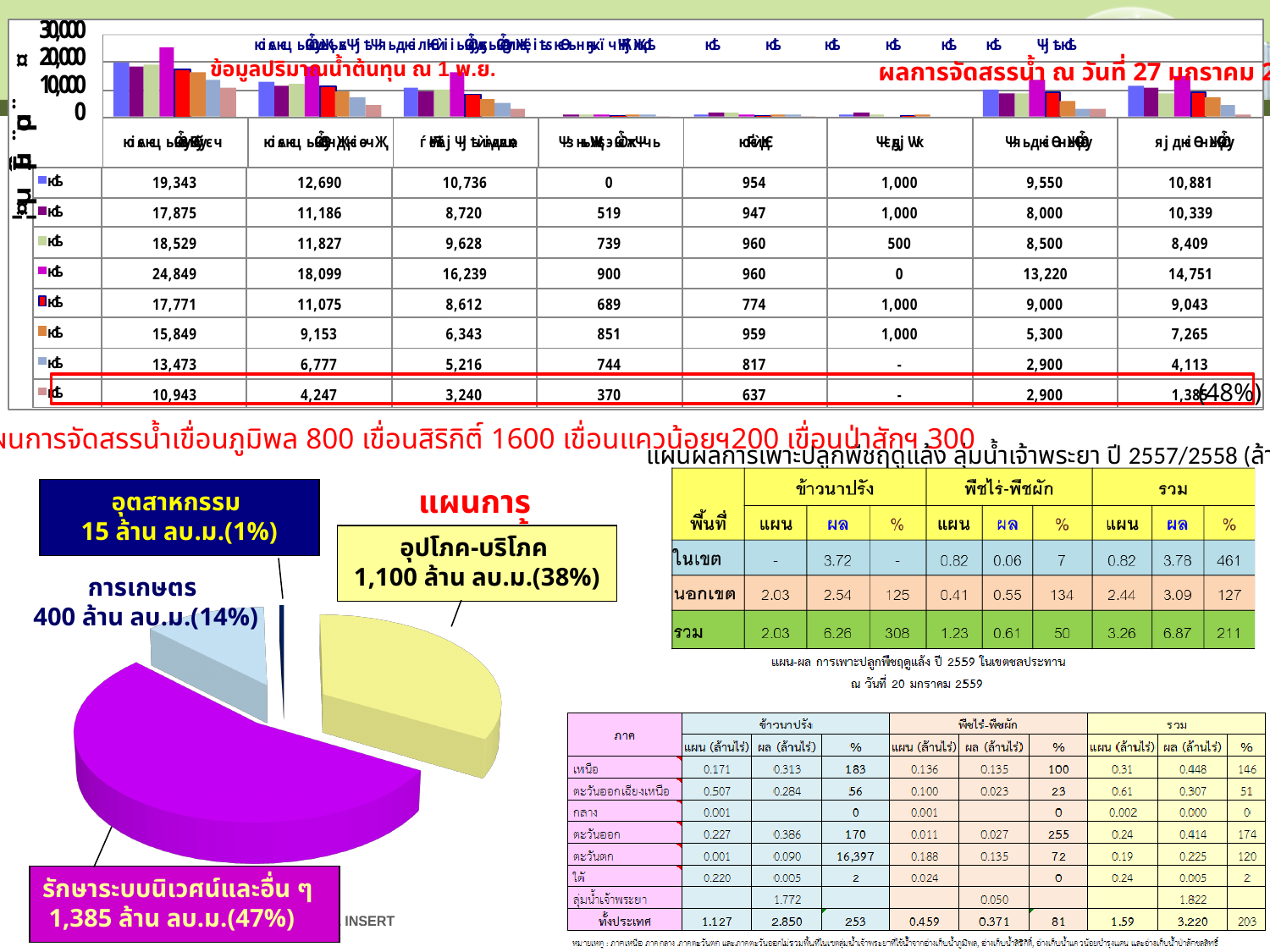
In the pie chart at the bottom left, what is the value for การเกษตร? 400 ล้าน ลบ.ม. What kind of chart is the chart at the bottom left of the slide? pie chart In the pie chart at the bottom left, which is larger: อุปโภค-บริโภค or การเกษตร? อุปโภค-บริโภค In the pie chart at the bottom left, what is the difference between the values for รักษาระบบนิเวศน์และอื่น ๆ and อุปโภค-บริโภค? 285 ล้าน ลบ.ม. In the pie chart at the bottom left, what is the value for อุตสาหกรรม? 15 ล้าน ลบ.ม. In the pie chart at the bottom left, what colour is the slice for รักษาระบบนิเวศน์และอื่น ๆ? magenta In the pie chart at the bottom left, which slice is the largest? รักษาระบบนิเวศน์และอื่น ๆ In the pie chart at the bottom left, what share does อุปโภค-บริโภค have? 38% In the pie chart at the bottom left, which slice is the smallest? อุตสาหกรรม What kind of chart is the chart at the top of the slide? bar chart In the pie chart at the bottom left, how many slices are there? 4 In the bar chart at the top of the slide, how many categories are shown along the x axis? 8